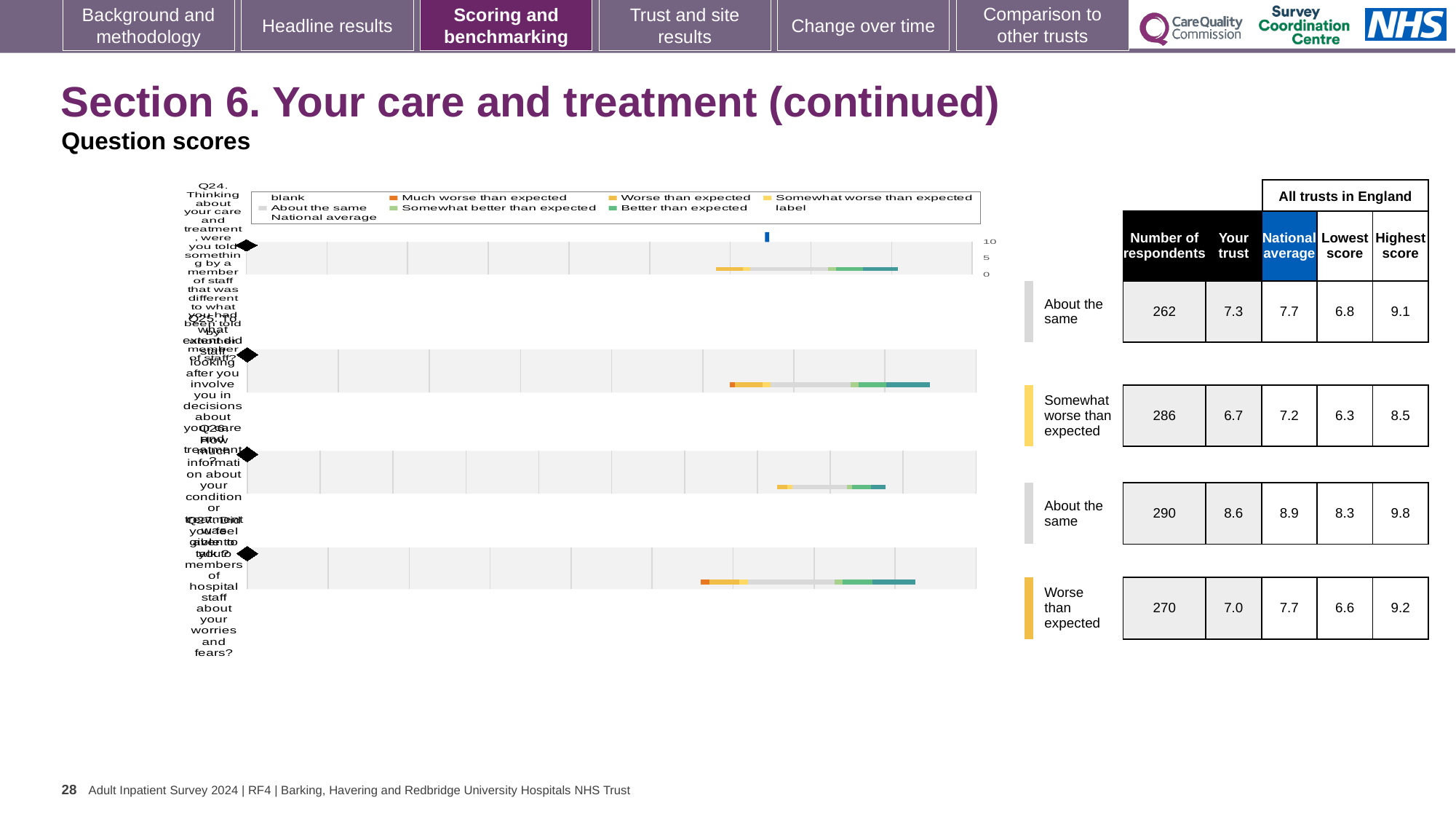
Which question has the highest 'Your trust' score in the table beside the chart? Q26 What kind of chart is shown on the slide? bar chart Which question has the lowest 'Your trust' score in the table beside the chart? Q25 For Q26, what is the difference between the national average and the 'Your trust' score? 0.3 What is the 'Your trust' score for Q25 shown in the table beside the chart? 6.7 How many respondents are listed for Q27? 270 What colour does the legend use for 'Much worse than expected'? orange What is the maximum value shown on the chart's score axis? 10 What is the national average score for Q26 shown in the table beside the chart? 8.9 For Q24, which is larger: the 'Your trust' score or the national average? National average How many questions (bars) are plotted in the chart? 4 What benchmark category is Q27 assigned to? Worse than expected